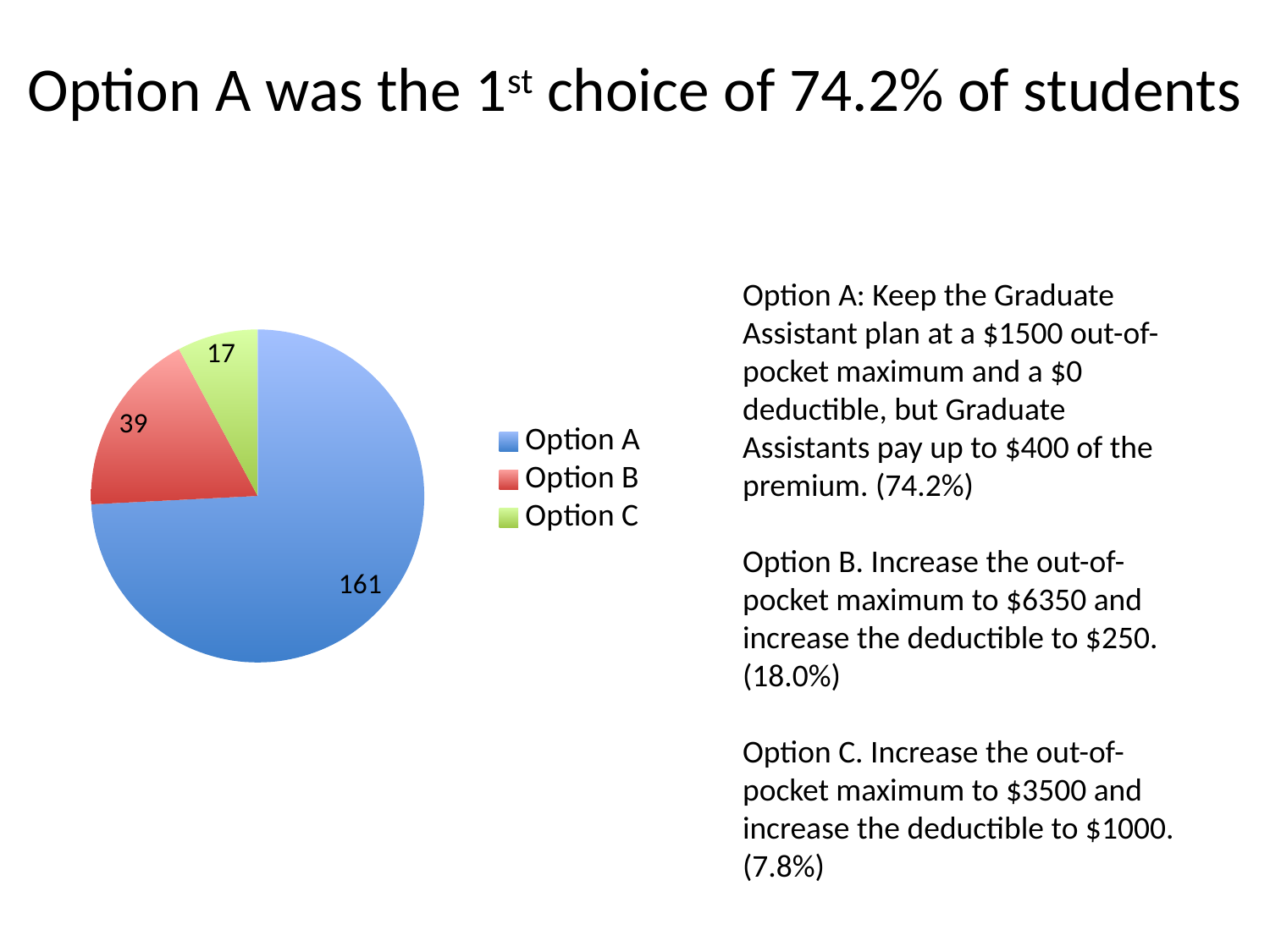
What is the value shown for Option C? 17 Which option has the largest slice of the pie? Option A What colour is the slice for Option C? green What type of chart is shown on the slide? pie chart Which option has the smallest slice of the pie? Option C What is the total of all the values shown in the pie chart? 217 What is the difference between the values for Option A and Option B? 122 How many slices does the pie chart have? 3 Which is larger, the value for Option B or the value for Option C? Option B What is the value shown for Option B? 39 How many students chose Option A as their first choice? 161 What is the difference between the values for Option B and Option C? 22